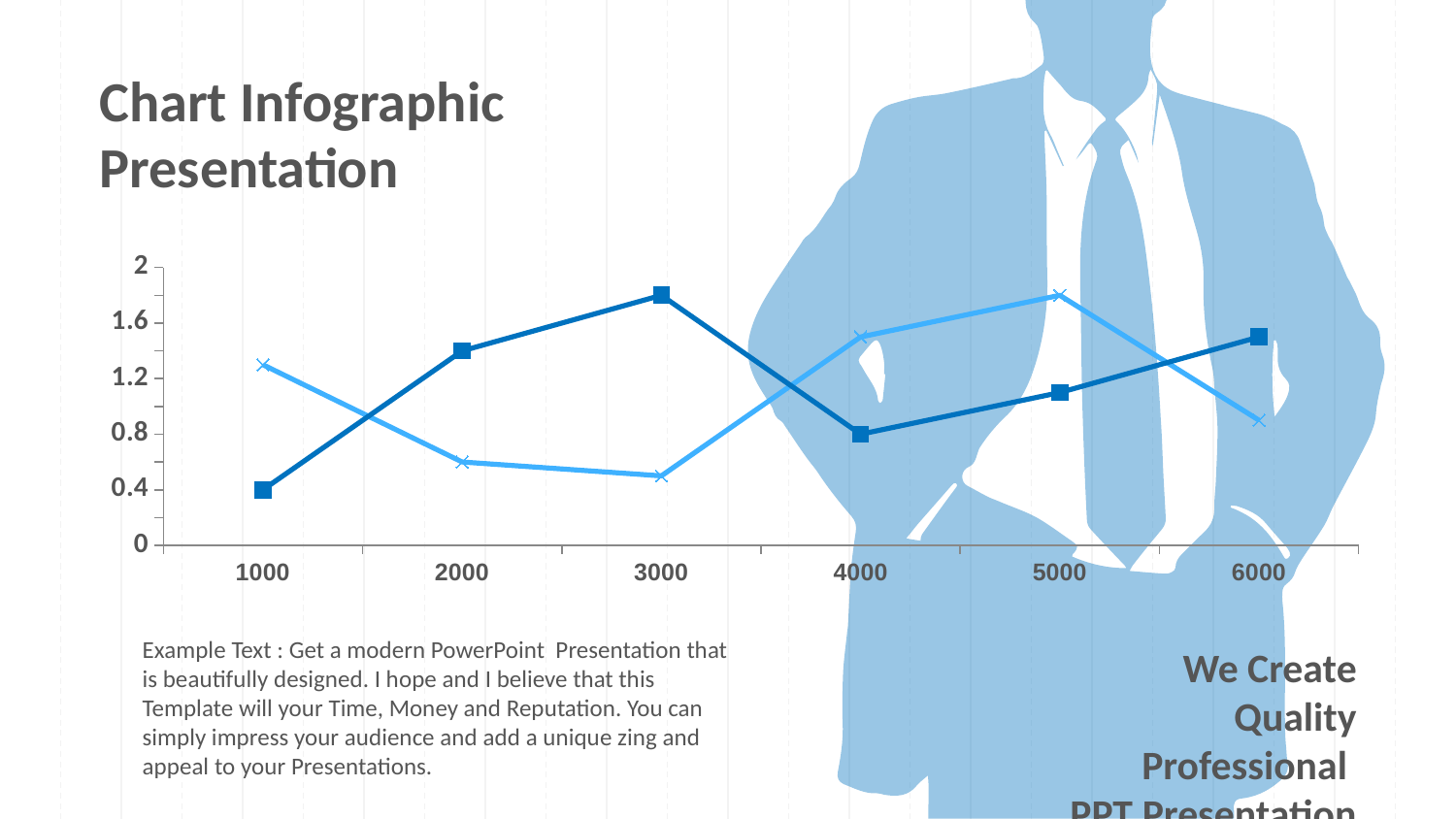
Is the value of the light blue line with x markers at 3000 greater or less than 0.8? less What kind of chart is shown on the slide? line chart At which x-axis value does the light blue line with x markers reach its lowest point? 3000 Does the dark blue line with square markers rise or fall from 1000 to 3000? rise How many lines are plotted on the chart? 2 Is the value of the light blue line with x markers at 5000 greater or less than 1.6? greater At 2000, which line is higher: the dark blue line with square markers or the light blue line with x markers? the dark blue line with square markers At which x-axis value does the dark blue line with square markers reach its highest point? 3000 What is the value of the dark blue line with square markers at 1000? 0.4 How many x-axis categories does the chart have? 6 Is the value of the dark blue line with square markers at 3000 greater or less than 1.6? greater At 4000, which line is higher: the dark blue line with square markers or the light blue line with x markers? the light blue line with x markers